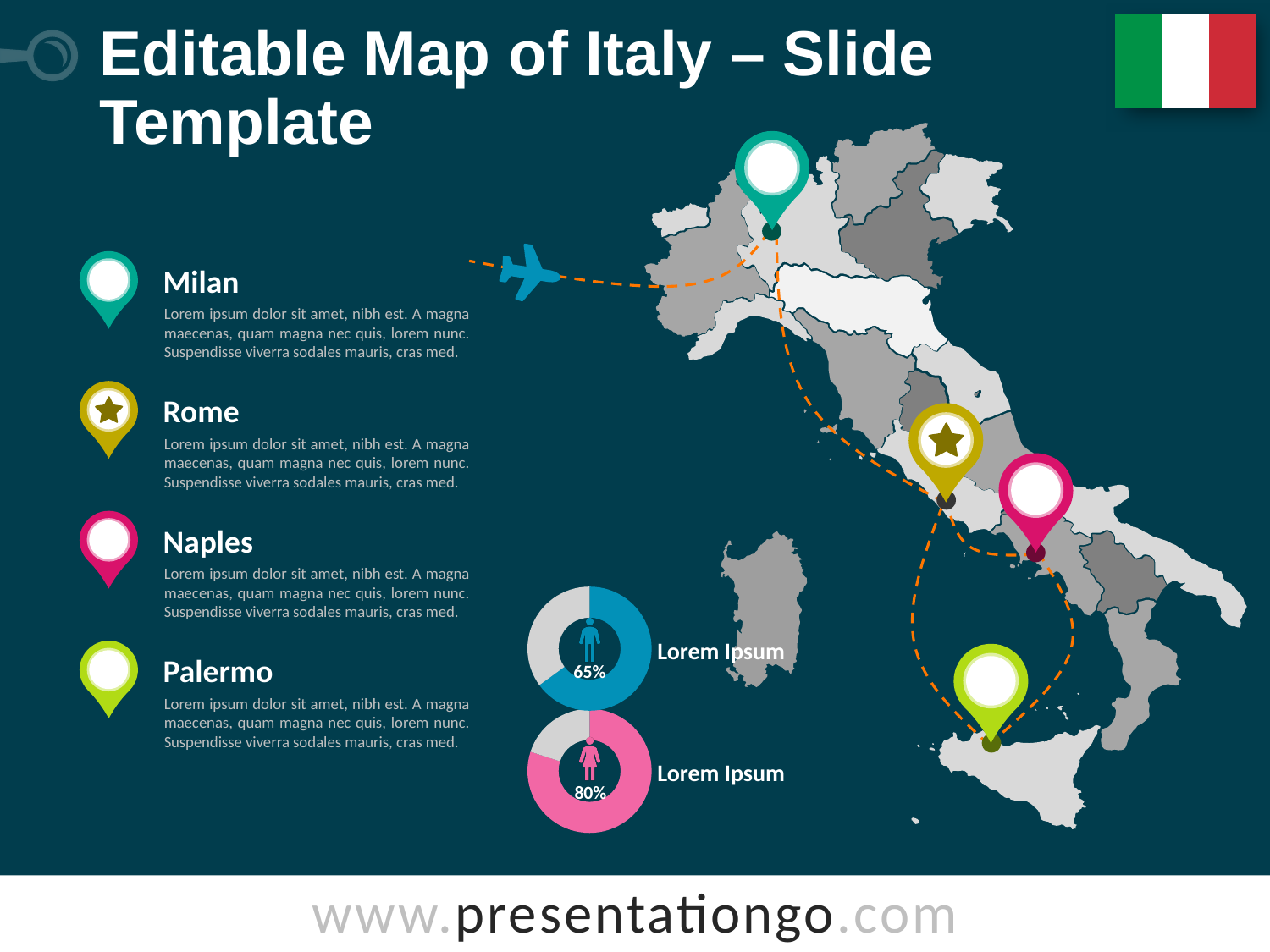
What percentage is shown in the lower (pink) donut chart? 80% What kind of charts are shown at the bottom centre of the slide? donut (pie) charts What text label appears to the right of each donut chart? Lorem Ipsum What is the difference between the percentage in the lower pink donut chart and the percentage in the upper blue donut chart? 15% How many donut charts are on the slide? 2 What colour is the filled portion of the upper donut chart? blue What percentage is shown in the upper (blue) donut chart? 65% Which donut chart shows the larger percentage, the upper blue one or the lower pink one? the lower pink one What share of the lower donut chart is filled in pink? 80%